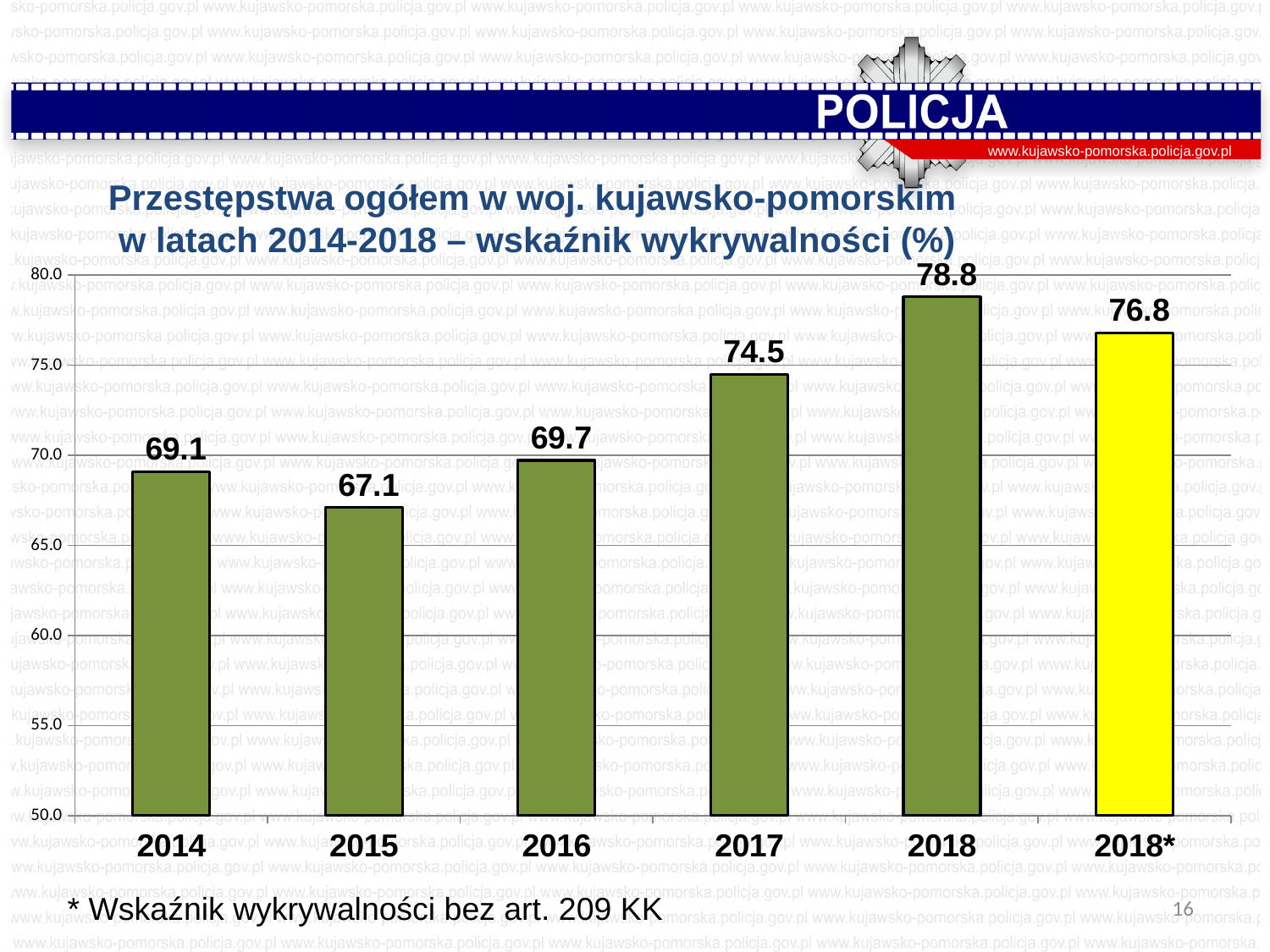
What kind of chart is shown on the slide? bar chart What is the detection rate value shown for 2017? 74.5 Which category has the lowest value? 2015 Which category has the highest value? 2018 Is the value for 2017 greater or less than 70.0? greater What is the difference between the values for 2018 and 2018*? 2.0 What is the difference between the values for 2018 and 2014? 9.7 What value is shown for the bar labelled 2018*? 76.8 How many bars are plotted on the chart? 6 Which bar is coloured yellow instead of green? 2018* What is the value shown for 2015? 67.1 Which is larger, the value for 2016 or the value for 2014? 2016